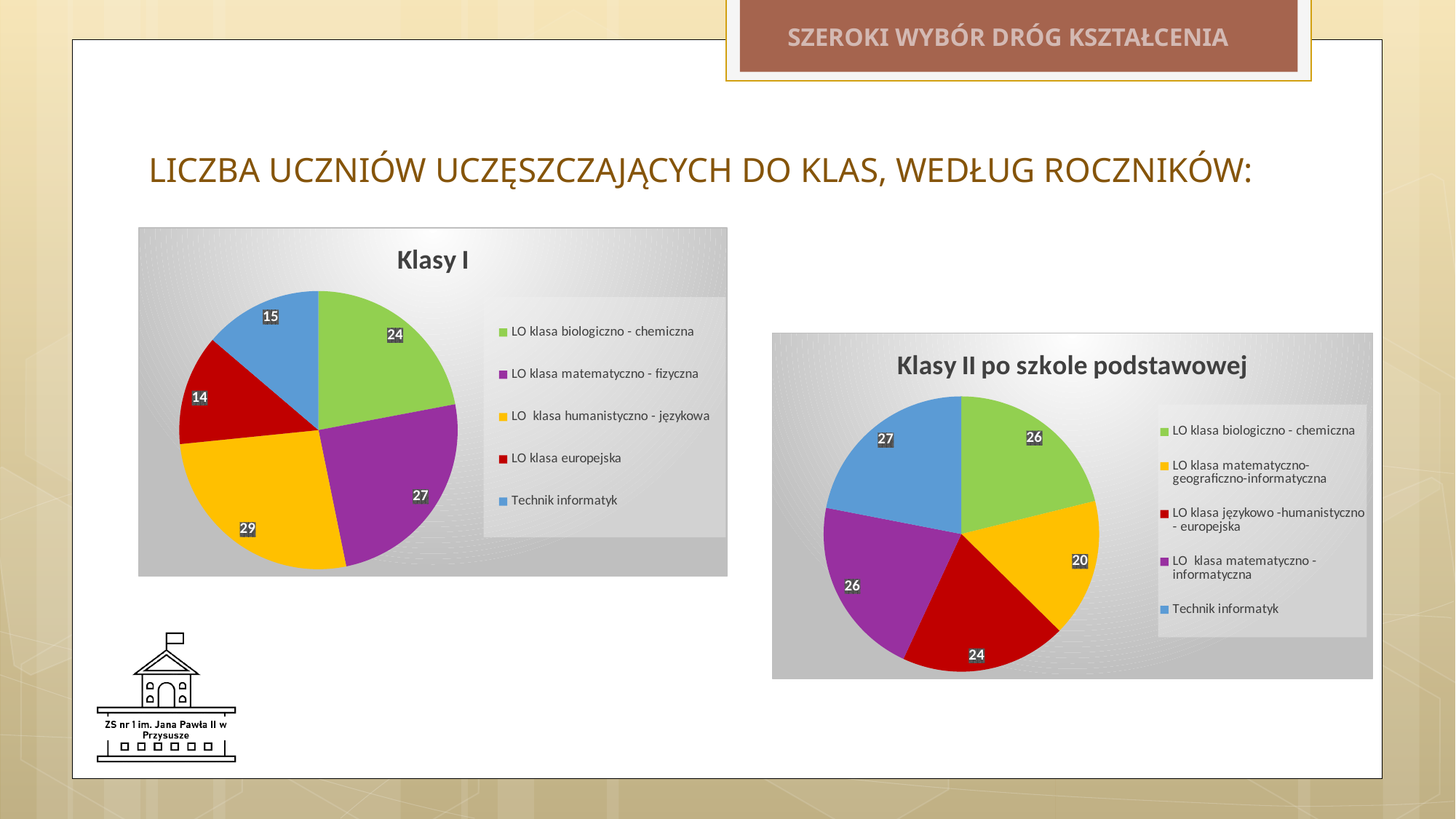
In the 'Klasy I' chart, which category has the lowest value? LO klasa europejska In the 'Klasy I' chart, what is the value for Technik informatyk? 15 In the 'Klasy II po szkole podstawowej' chart, which category has the lowest value? LO klasa matematyczno-geograficzno-informatyczna In the 'Klasy I' chart, how many categories are shown? 5 In the 'Klasy II po szkole podstawowej' chart, which is larger: LO klasa językowo -humanistyczno - europejska or LO klasa matematyczno-geograficzno-informatyczna? LO klasa językowo -humanistyczno - europejska In the 'Klasy II po szkole podstawowej' chart, what is the value for LO klasa matematyczno-geograficzno-informatyczna? 20 In the 'Klasy I' chart, what is the difference between LO klasa matematyczno - fizyczna and LO klasa europejska? 13 What type of chart is 'Klasy I'? Pie chart In the 'Klasy II po szkole podstawowej' chart, what colour is the Technik informatyk slice? Blue In the 'Klasy II po szkole podstawowej' chart, which category has the highest value? Technik informatyk In the 'Klasy I' chart, what is the value for LO klasa humanistyczno - językowa? 29 In the 'Klasy I' chart, which category has the highest value? LO klasa humanistyczno - językowa